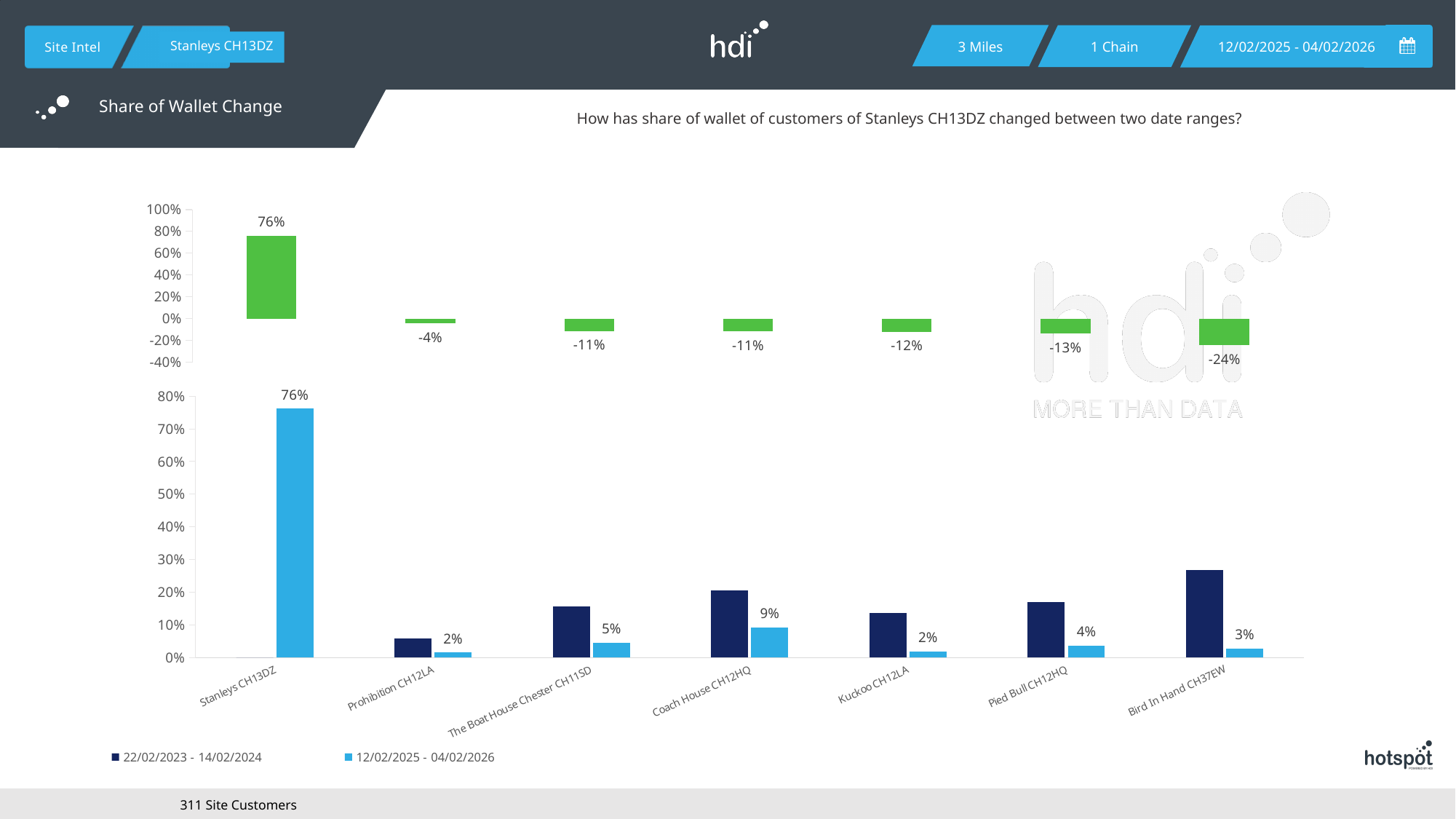
In the top chart, what is the share of wallet change for Kuckoo CH12LA? -12% In the bottom chart, how many series does the legend list? 2 In the top chart, what is the share of wallet change for Stanleys CH13DZ? 76% In the top chart, how many categories are plotted? 7 In the top chart, what is the share of wallet change for Bird In Hand CH37EW? -24% In the top chart, which category has the lowest share of wallet change? Bird In Hand CH37EW In the bottom chart, is the 22/02/2023 - 14/02/2024 value for Bird In Hand CH37EW greater or less than 20%? greater In the bottom chart, which is larger for Pied Bull CH12HQ: the 22/02/2023 - 14/02/2024 value or the 12/02/2025 - 04/02/2026 value? 22/02/2023 - 14/02/2024 In the bottom chart, what is the difference between the 12/02/2025 - 04/02/2026 values for Coach House CH12HQ and Prohibition CH12LA? 7% In the bottom chart, what is the value for The Boat House Chester CH11SD in the 12/02/2025 - 04/02/2026 series? 5% In the bottom chart, what is the value for Coach House CH12HQ in the 12/02/2025 - 04/02/2026 series? 9% What kind of chart is the bottom chart? Bar chart